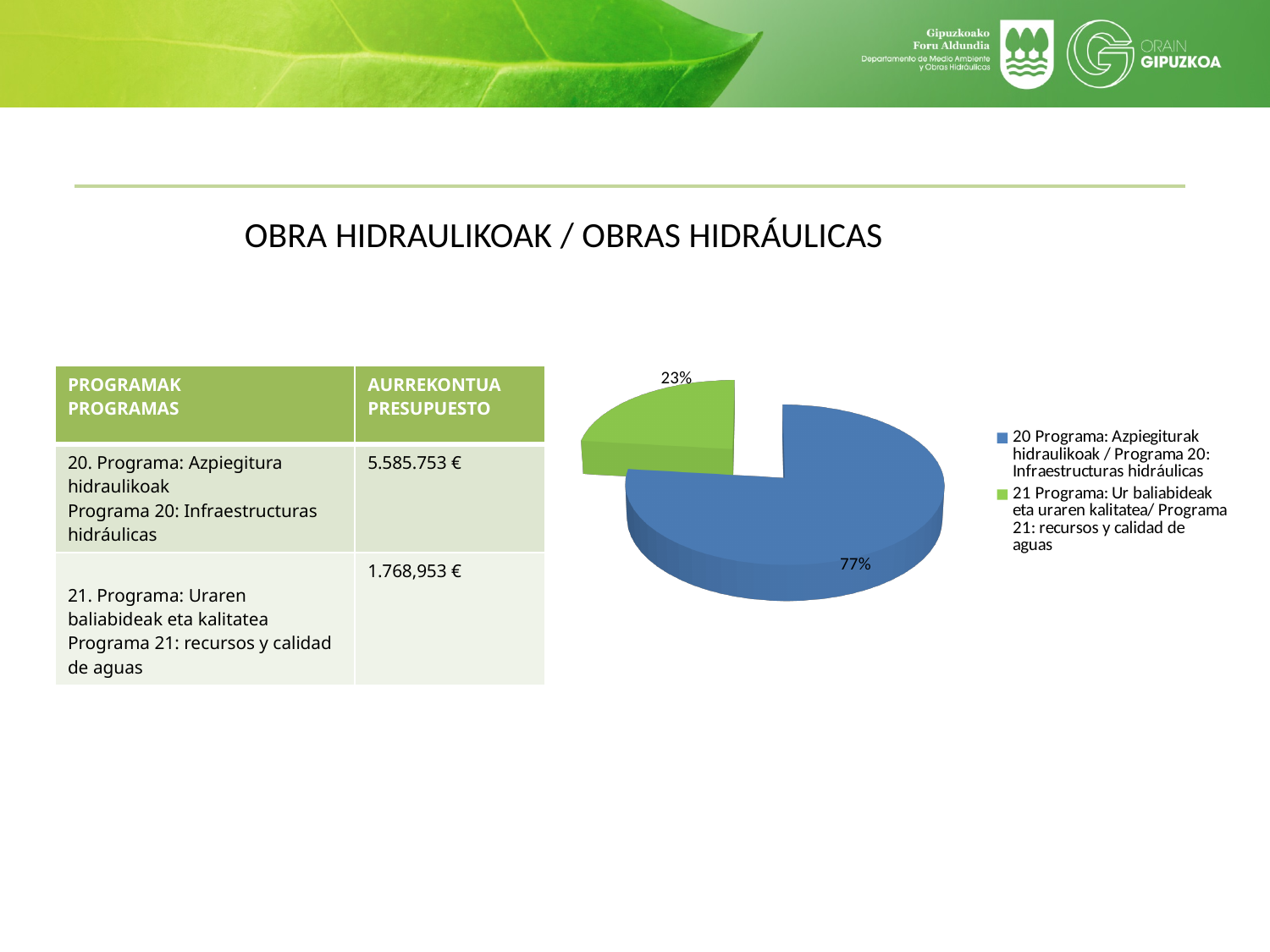
What share of the pie does Programa 20 (Infraestructuras hidráulicas) represent? 77% What is the difference in percentage points between the Programa 20 slice and the Programa 21 slice? 54 Which programme has the smallest slice of the pie? 21 Programa: Ur baliabideak eta uraren kalitatea / Programa 21: recursos y calidad de aguas What kind of chart is shown on the slide? pie chart How many entries does the chart legend list? 2 What share of the pie does Programa 21 (recursos y calidad de aguas) represent? 23% Which slice is larger, Programa 20 or Programa 21? Programa 20 What colour is the slice for Programa 20 in the pie chart? blue How many slices does the pie chart have? 2 Which programme has the largest slice of the pie? 20 Programa: Azpiegiturak hidraulikoak / Programa 20: Infraestructuras hidráulicas What colour is the slice for Programa 21 in the pie chart? green